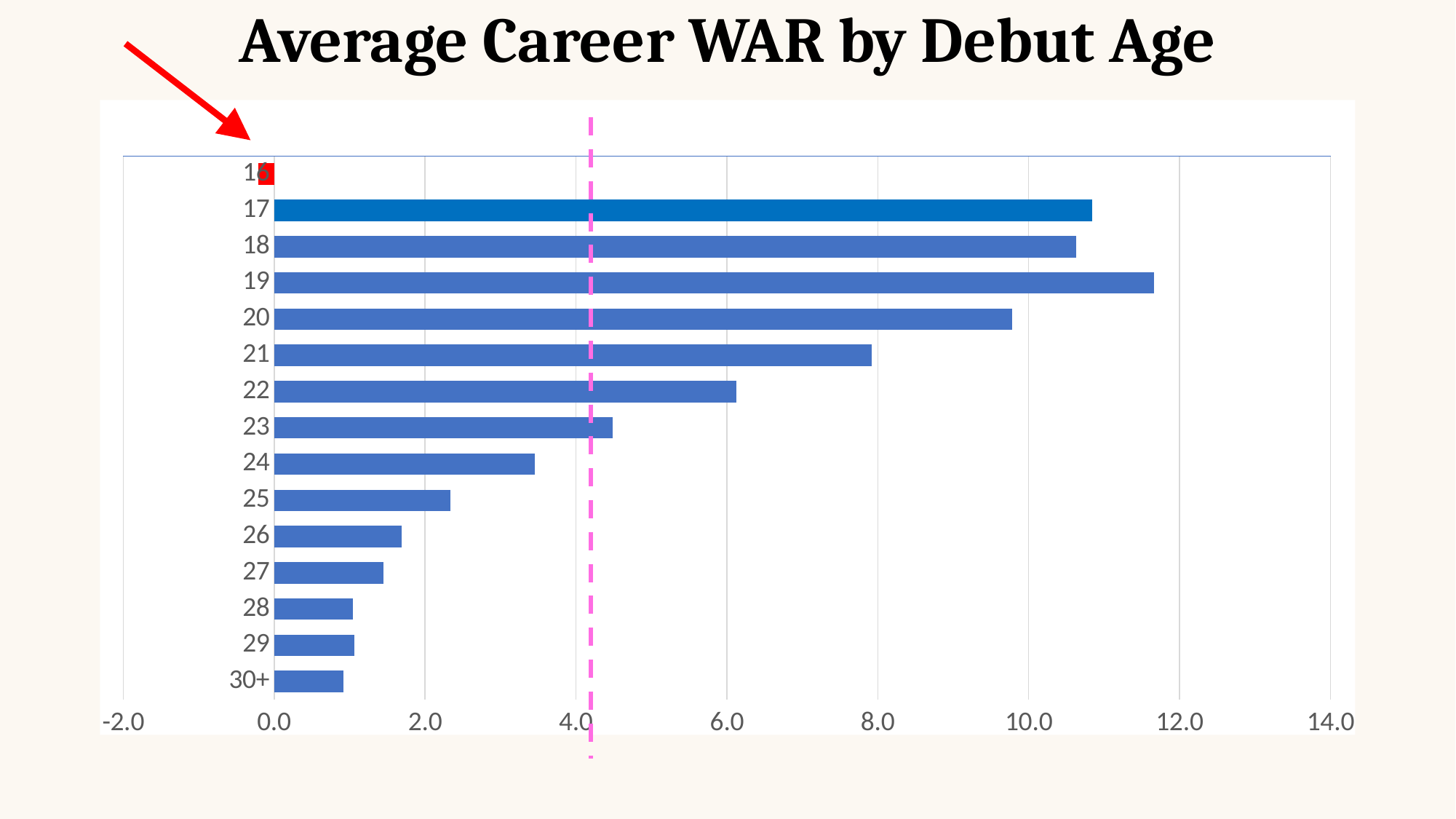
Is the value for debut age 20 greater or less than 10.0? less Which has a higher average career WAR, debut age 20 or debut age 21? 20 What kind of chart is shown on the slide? bar chart Is the value for debut age 26 greater or less than 2.0? less Which has a higher average career WAR, debut age 23 or debut age 22? 22 What is the title of the chart? Average Career WAR by Debut Age Which debut age has the lowest average career WAR? 16 From debut age 17 to 30+, do the average career WAR values generally rise or fall? fall How many debut age categories are plotted on the chart? 15 Is the value for debut age 17 greater or less than 10.0? greater Which debut age has the highest average career WAR? 19